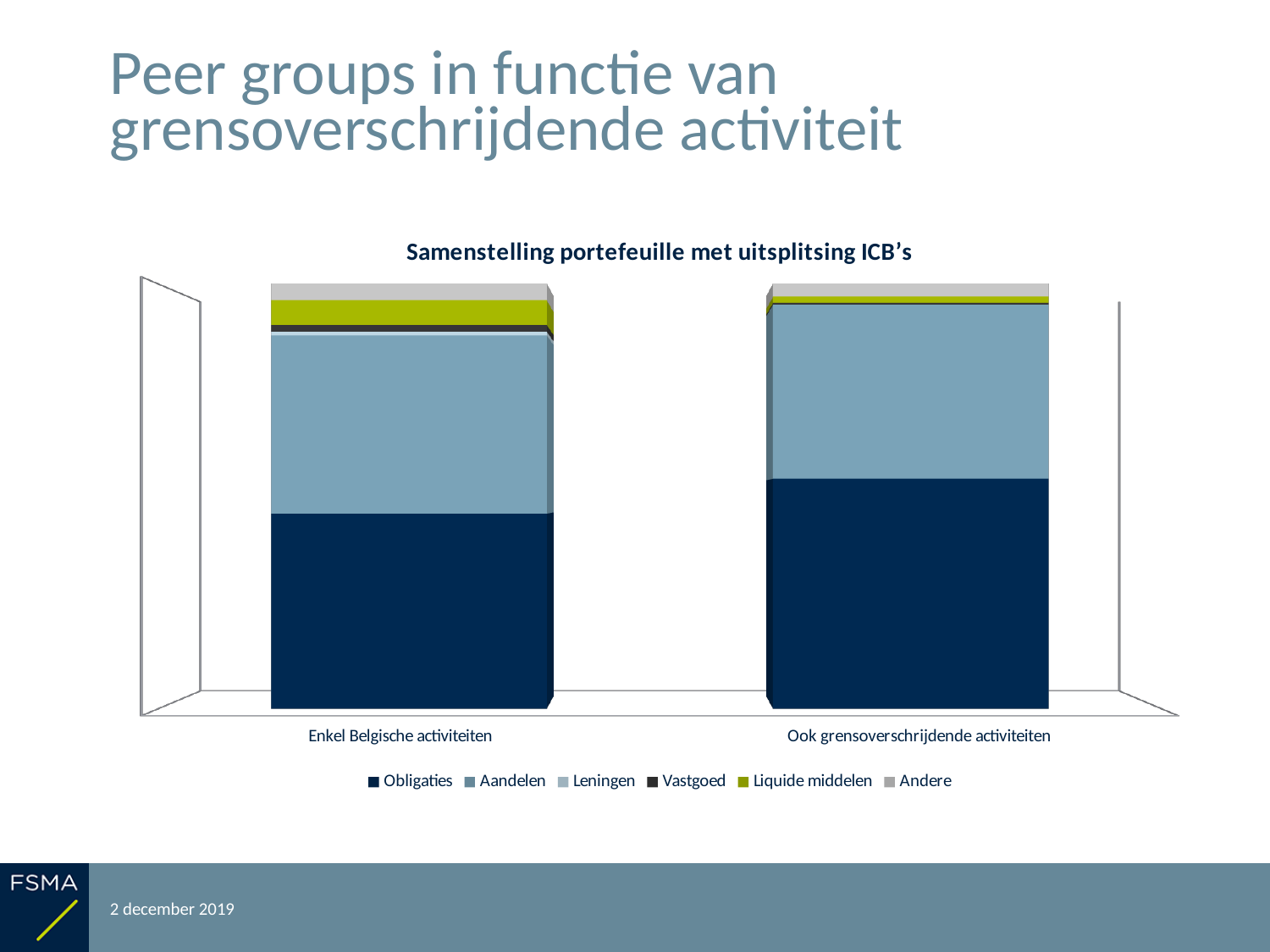
What is the title of the chart? Samenstelling portefeuille met uitsplitsing ICB's Which series makes up the largest segment of the 'Enkel Belgische activiteiten' bar? Obligaties Which series makes up the largest segment of the 'Ook grensoverschrijdende activiteiten' bar? Obligaties Is the Liquide middelen segment larger for 'Enkel Belgische activiteiten' or for 'Ook grensoverschrijdende activiteiten'? Enkel Belgische activiteiten What is the label of the second bar on the x axis of the chart? Ook grensoverschrijdende activiteiten What kind of chart is shown on the slide? Stacked bar chart Is the Andere segment larger for 'Enkel Belgische activiteiten' or for 'Ook grensoverschrijdende activiteiten'? Enkel Belgische activiteiten How many categories (bars) are shown on the x axis of the chart? 2 How many series does the chart legend list? 6 Which series is listed first in the chart legend? Obligaties Is the Vastgoed segment larger for 'Enkel Belgische activiteiten' or for 'Ook grensoverschrijdende activiteiten'? Enkel Belgische activiteiten